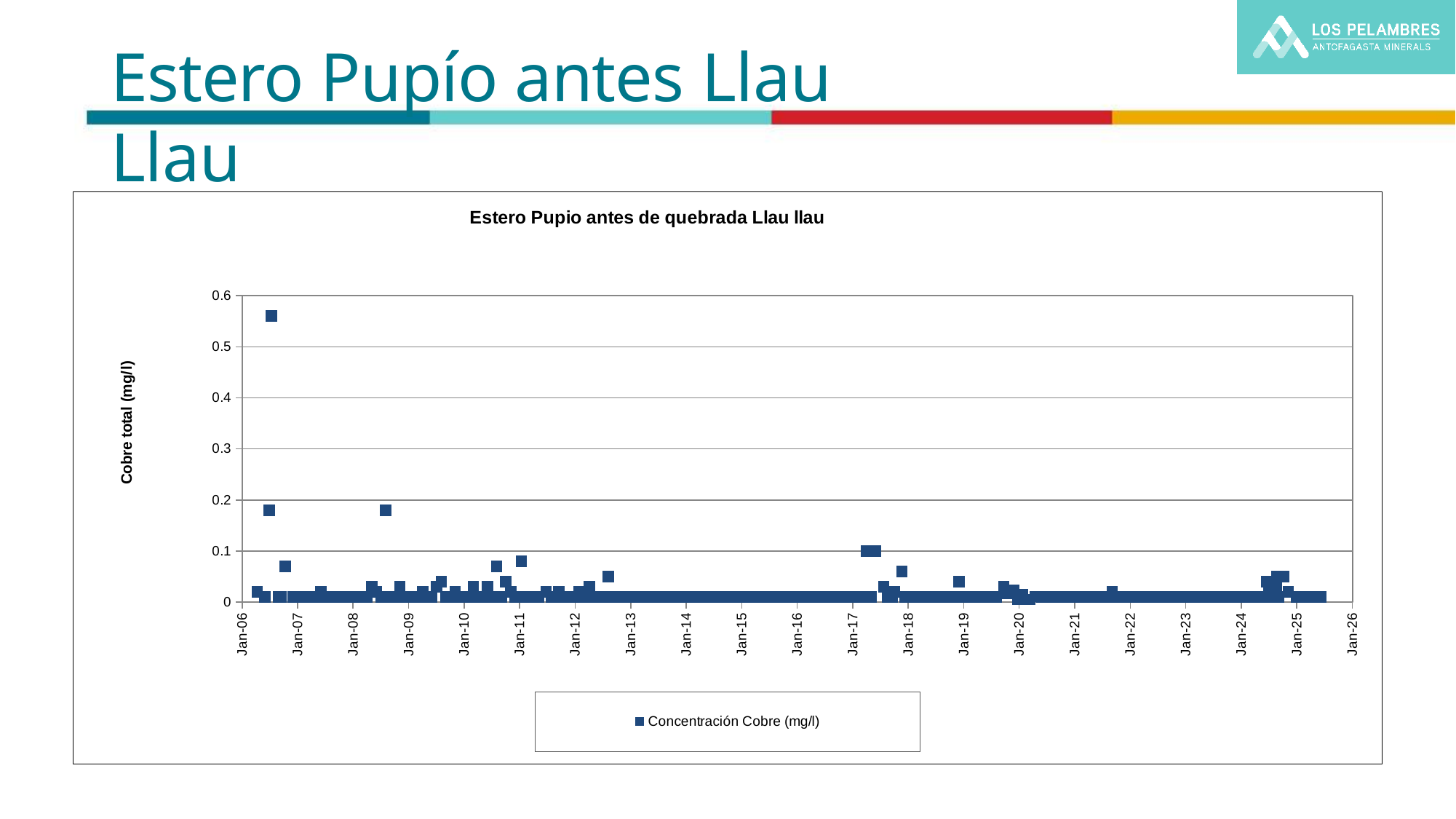
Which is larger: the highest value in 2006 or the highest value between Jan-17 and Jan-18? the highest value in 2006 In which year does the highest copper concentration value occur? 2006 What kind of chart is shown on the slide? scatter chart What is the legend entry for the plotted series? Concentración Cobre (mg/l) What is the title of the chart? Estero Pupio antes de quebrada Llau llau Is the highest value plotted between Jan-08 and Jan-09 greater or less than 0.2? less Are the values plotted between Jan-13 and Jan-17 greater or less than 0.1? less Is the highest plotted value greater or less than 0.6? less How many series does the legend list? 1